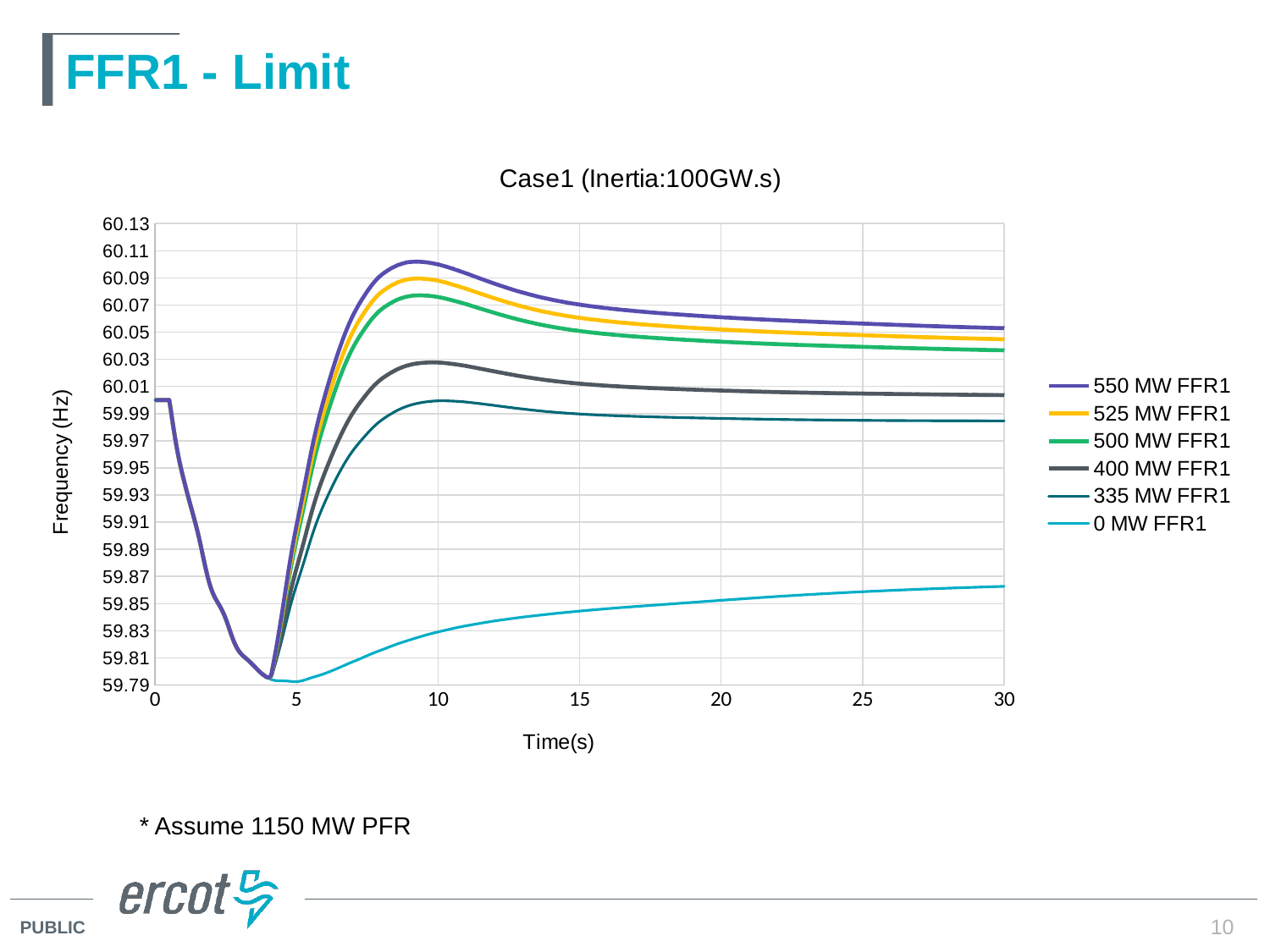
Is the peak value of the 550 MW FFR1 series greater or less than 60.07? greater What is the label of the y axis? Frequency (Hz) Between 10 and 30 seconds, does the 550 MW FFR1 series rise or fall? fall Which series has the highest frequency at 30 seconds? 550 MW FFR1 What kind of chart is shown on the slide? line chart How many series does the legend list? 6 At 30 seconds, which is higher: 550 MW FFR1 or 500 MW FFR1? 550 MW FFR1 Is the lowest frequency reached by the curves (around 4 seconds) greater or less than 59.81? less Is the peak value of the 400 MW FFR1 series greater or less than 60.01? greater Which series has the lowest frequency at 30 seconds? 0 MW FFR1 What is the title of the chart? Case1 (Inertia:100GW.s)